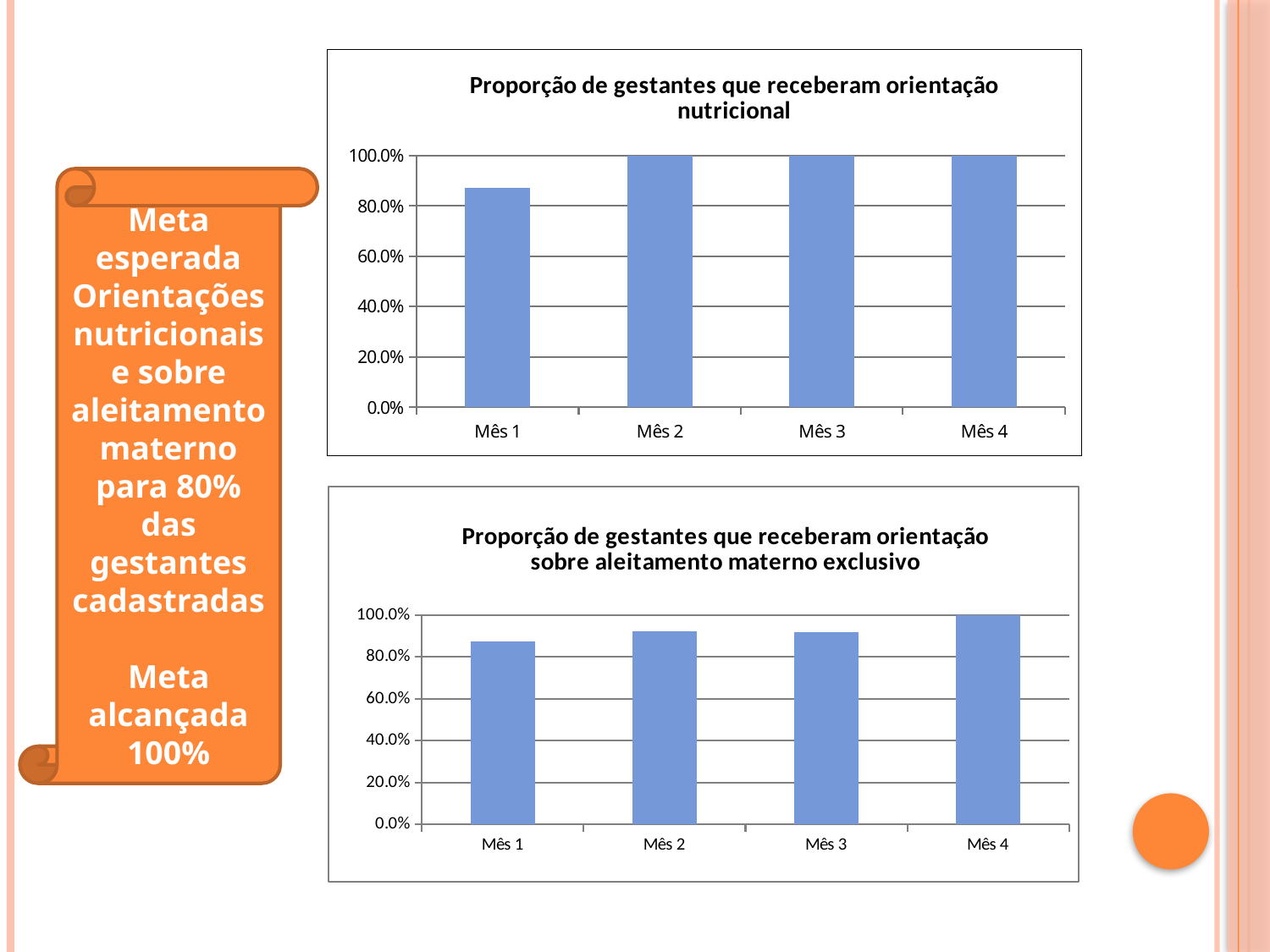
In the top chart, 'Proporção de gestantes que receberam orientação nutricional', what is the value for Mês 4? 100.0% In the bottom chart, 'Proporção de gestantes que receberam orientação sobre aleitamento materno exclusivo', which month has the lowest value? Mês 1 In the top chart, 'Proporção de gestantes que receberam orientação nutricional', how many months are shown on the x axis? 4 In the top chart, 'Proporção de gestantes que receberam orientação nutricional', what is the value for Mês 2? 100.0% What is the title of the bottom chart on the slide? Proporção de gestantes que receberam orientação sobre aleitamento materno exclusivo In the bottom chart, 'Proporção de gestantes que receberam orientação sobre aleitamento materno exclusivo', is the value for Mês 2 greater or less than 80.0%? greater What kind of chart is the top chart, 'Proporção de gestantes que receberam orientação nutricional'? bar chart In the top chart, 'Proporção de gestantes que receberam orientação nutricional', is the value for Mês 1 greater or less than 80.0%? greater In the bottom chart, 'Proporção de gestantes que receberam orientação sobre aleitamento materno exclusivo', which month has the highest value? Mês 4 In the top chart, 'Proporção de gestantes que receberam orientação nutricional', which month has the lowest value? Mês 1 In the bottom chart, 'Proporção de gestantes que receberam orientação sobre aleitamento materno exclusivo', what is the value for Mês 4? 100.0% In the bottom chart, 'Proporção de gestantes que receberam orientação sobre aleitamento materno exclusivo', which is larger, the value for Mês 1 or the value for Mês 4? Mês 4